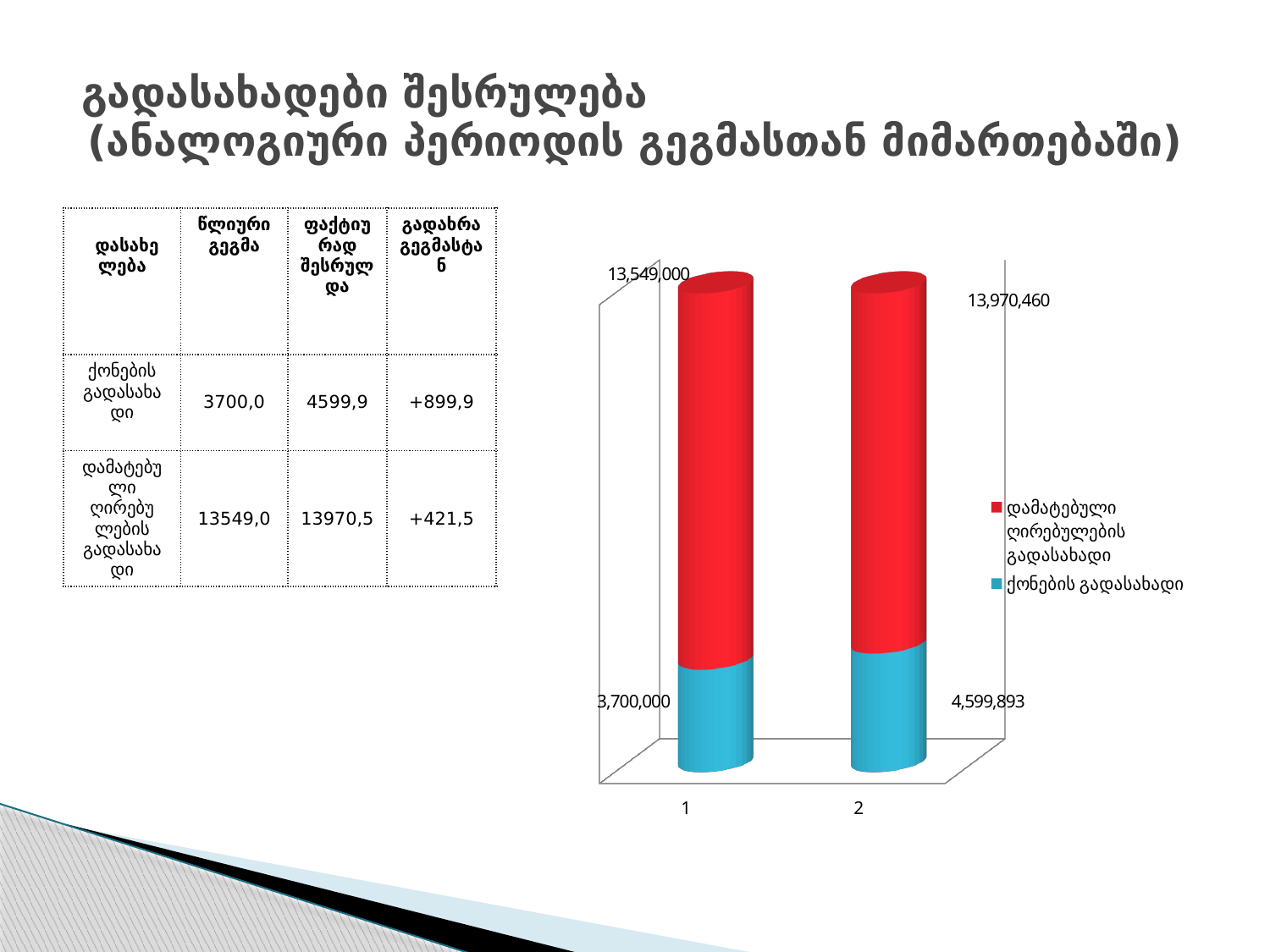
How many categories are shown on the x axis of the chart? 2 What is the value of ქონების გადასახადი for category 1? 3,700,000 How many series does the chart legend list? 2 What is the value of დამატებული ღირებულების გადასახადი for category 1? 13,549,000 What is the value of დამატებული ღირებულების გადასახადი for category 2? 13,970,460 What is the difference between the ქონების გადასახადი values for category 2 and category 1? 899,893 What is the value of ქონების გადასახადი for category 2? 4,599,893 What is the total of the stacked bar for category 1? 17,249,000 Which colour represents დამატებული ღირებულების გადასახადი in the chart? red What type of chart is shown on the slide? stacked bar chart What is the total of the stacked bar for category 2? 18,570,353 Which category has the larger value for ქონების გადასახადი, 1 or 2? 2